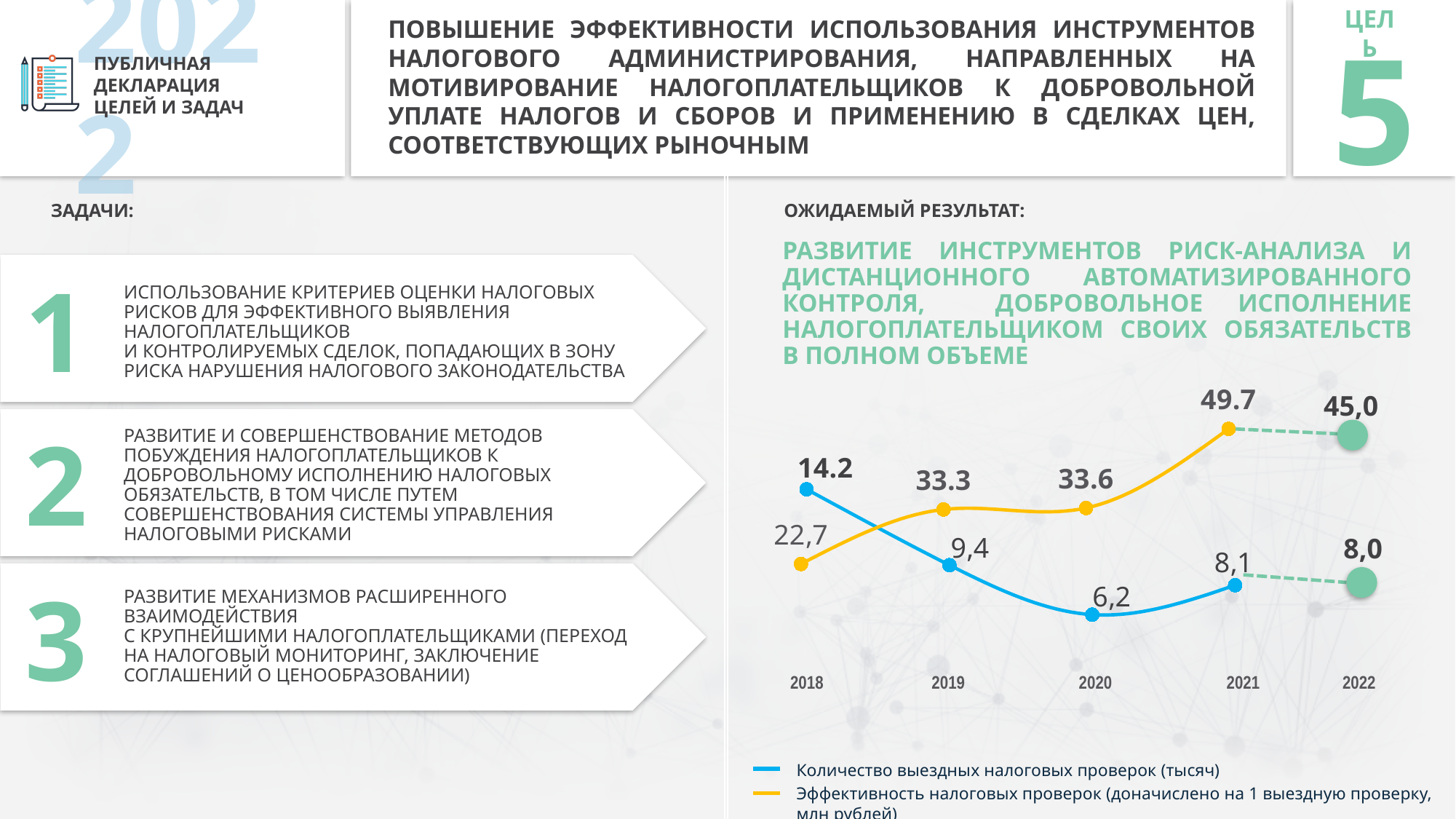
What kind of chart is shown on the slide? line chart In which year is Эффективность налоговых проверок highest? 2021 Does Количество выездных налоговых проверок (тысяч) rise or fall from 2018 to 2020? fall What is the difference between the Эффективность налоговых проверок values for 2021 and 2020? 16.1 What is the value of Количество выездных налоговых проверок (тысяч) for 2018? 14.2 What is the value of Эффективность налоговых проверок for 2022? 45,0 Which is larger in 2019: Количество выездных налоговых проверок (тысяч) or Эффективность налоговых проверок? Эффективность налоговых проверок What is the value of Эффективность налоговых проверок for 2021? 49.7 In which year is Количество выездных налоговых проверок (тысяч) lowest? 2020 How many years are plotted along the x axis of the chart? 5 How many series does the chart legend list? 2 What is the value of Количество выездных налоговых проверок (тысяч) for 2020? 6,2